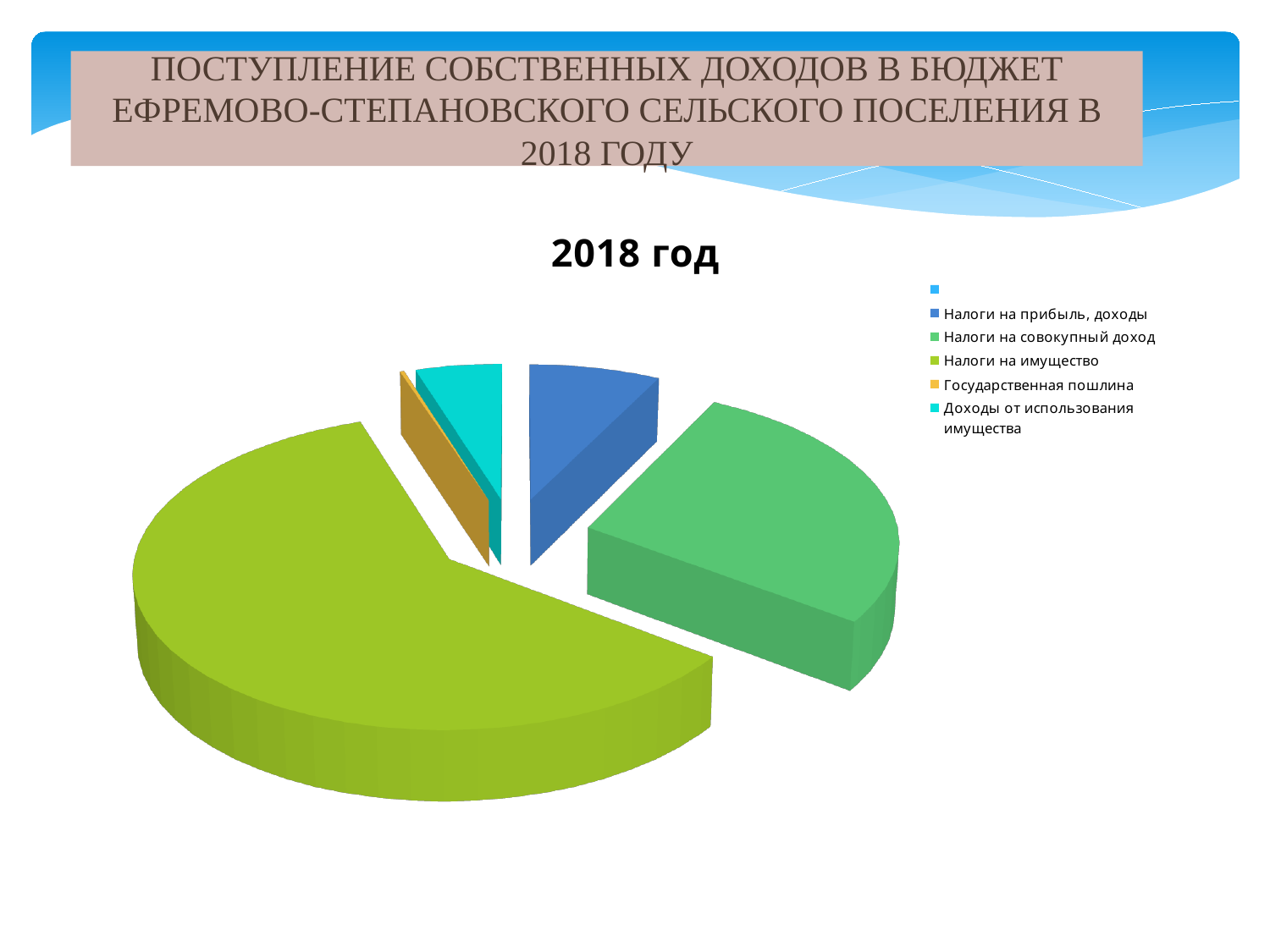
Which slice is larger: Налоги на совокупный доход or Налоги на прибыль, доходы? Налоги на совокупный доход Does the slice for Налоги на имущество make up more or less than half of the pie? more Which slice is larger: Налоги на прибыль, доходы or Государственная пошлина? Налоги на прибыль, доходы What colour is the slice for Налоги на имущество? light green Which category has the smallest visible slice of the pie? Государственная пошлина How many slices are visible in the pie chart? 5 Which category has the largest slice of the pie? Налоги на имущество What is the title of the chart? 2018 год Which slice is larger: Налоги на имущество or Налоги на совокупный доход? Налоги на имущество What kind of chart is shown on the slide? pie chart